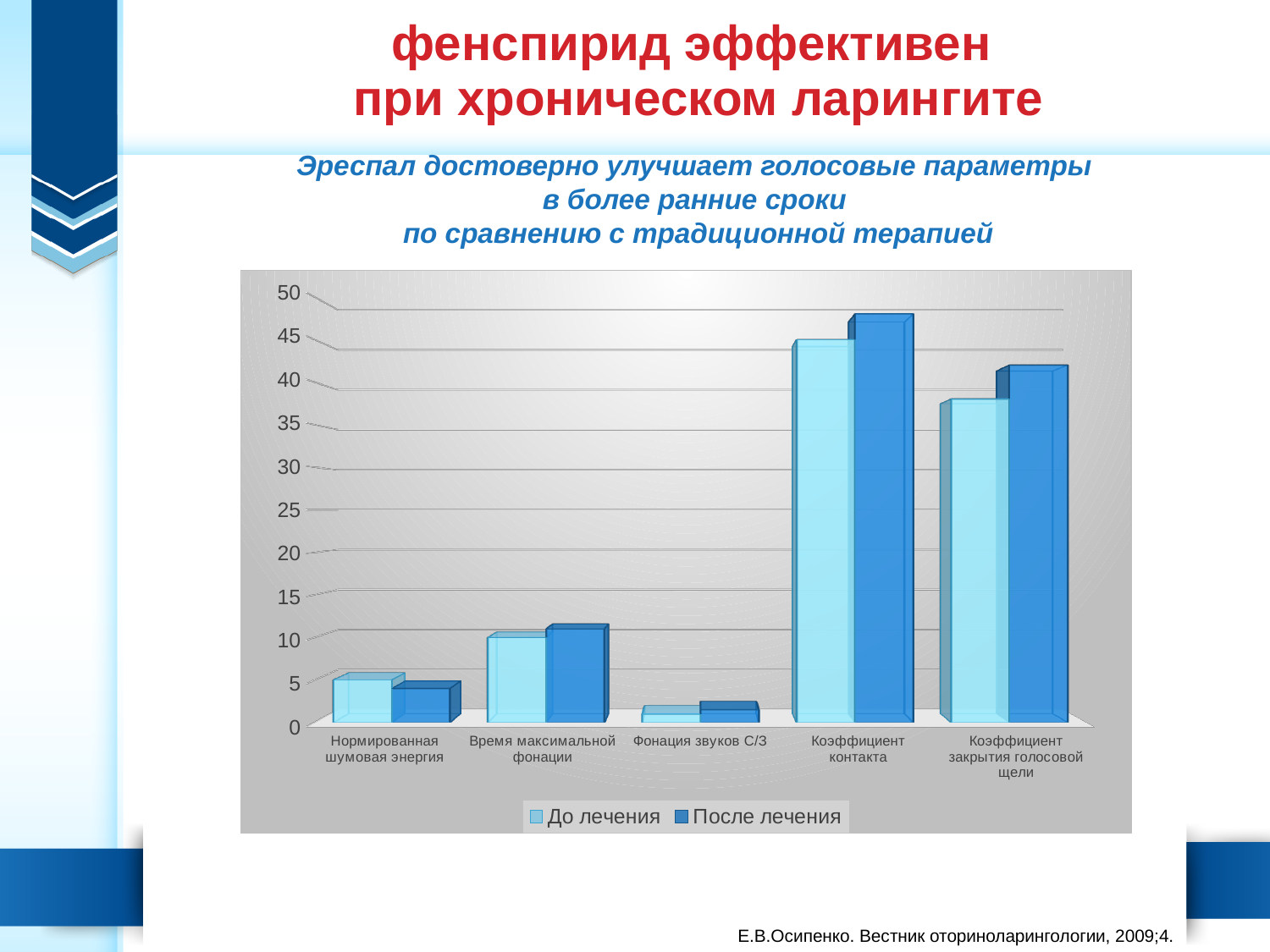
Which category has the lowest value for the series 'До лечения'? Фонация звуков С/З How many series does the chart legend list? 2 What kind of chart is shown on the slide? bar chart In the series 'До лечения', which is larger: 'Коэффициент контакта' or 'Коэффициент закрытия голосовой щели'? Коэффициент контакта Which category has the highest value for the series 'После лечения'? Коэффициент контакта How many categories are shown on the x axis of the chart? 5 For the category 'Коэффициент закрытия голосовой щели', which series has the larger value, 'До лечения' or 'После лечения'? После лечения Is the value for 'Нормированная шумовая энергия' in the series 'После лечения' greater or less than 5? less Is the value for 'Коэффициент закрытия голосовой щели' in the series 'До лечения' greater or less than 40? less What are the two series named in the chart legend? До лечения, После лечения Is the value for 'Фонация звуков С/З' in the series 'После лечения' greater or less than 5? less